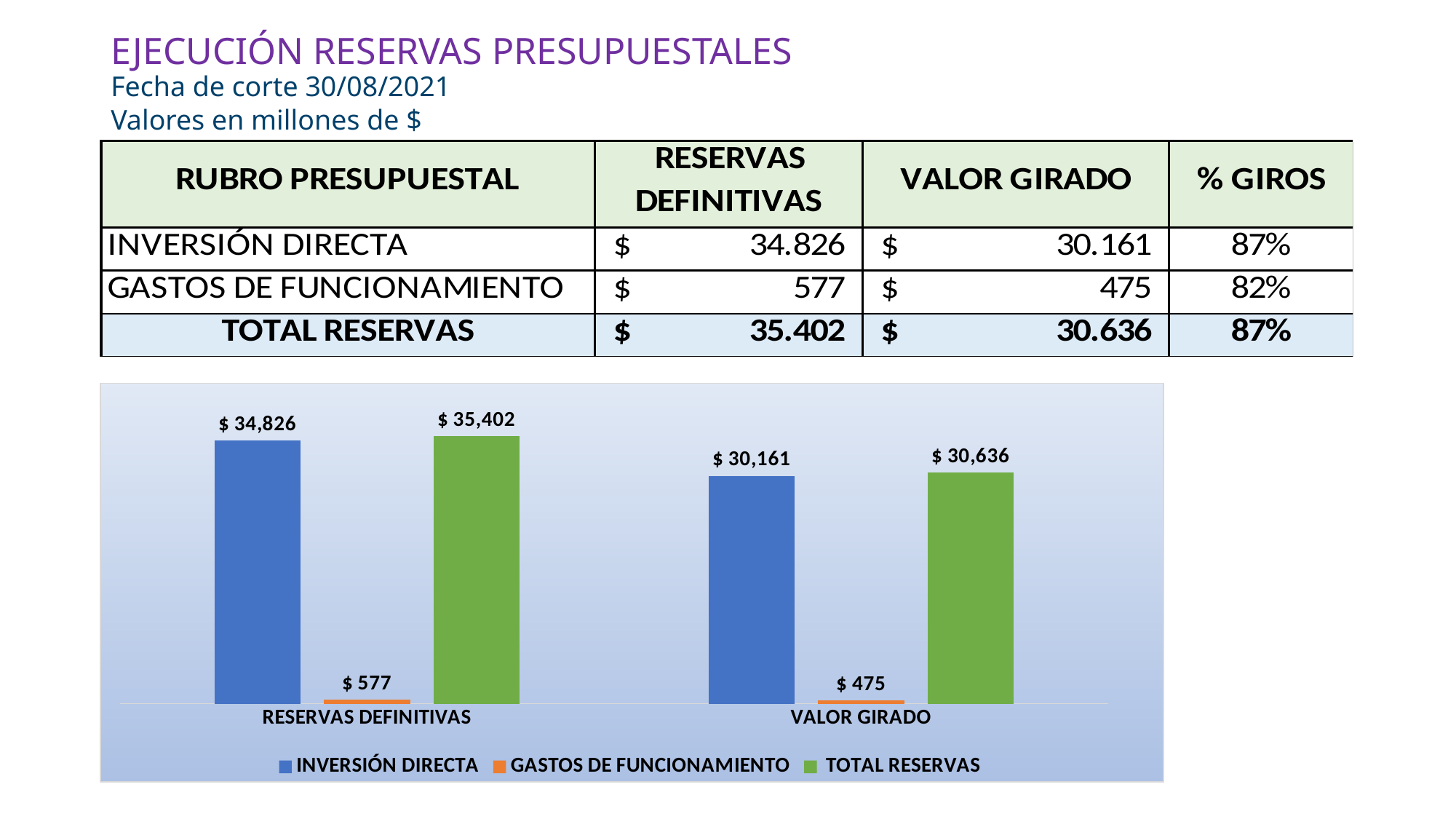
In the chart, is the TOTAL RESERVAS value larger for RESERVAS DEFINITIVAS or for VALOR GIRADO? RESERVAS DEFINITIVAS What is the value of INVERSIÓN DIRECTA for VALOR GIRADO in the chart? $ 30,161 How many series does the chart legend list? 3 What type of chart is shown on the slide? Bar chart What is the value of TOTAL RESERVAS for RESERVAS DEFINITIVAS in the chart? $ 35,402 Which series has the lowest value in the VALOR GIRADO group of the chart? GASTOS DE FUNCIONAMIENTO What is the difference between the INVERSIÓN DIRECTA values for RESERVAS DEFINITIVAS and VALOR GIRADO in the chart? $ 4,665 What is the difference between the GASTOS DE FUNCIONAMIENTO values for RESERVAS DEFINITIVAS and VALOR GIRADO in the chart? $ 102 How many categories are shown on the x axis of the chart? 2 What is the value of GASTOS DE FUNCIONAMIENTO for VALOR GIRADO in the chart? $ 475 What is the value of INVERSIÓN DIRECTA for RESERVAS DEFINITIVAS in the chart? $ 34,826 Which series has the highest value in the RESERVAS DEFINITIVAS group of the chart? TOTAL RESERVAS